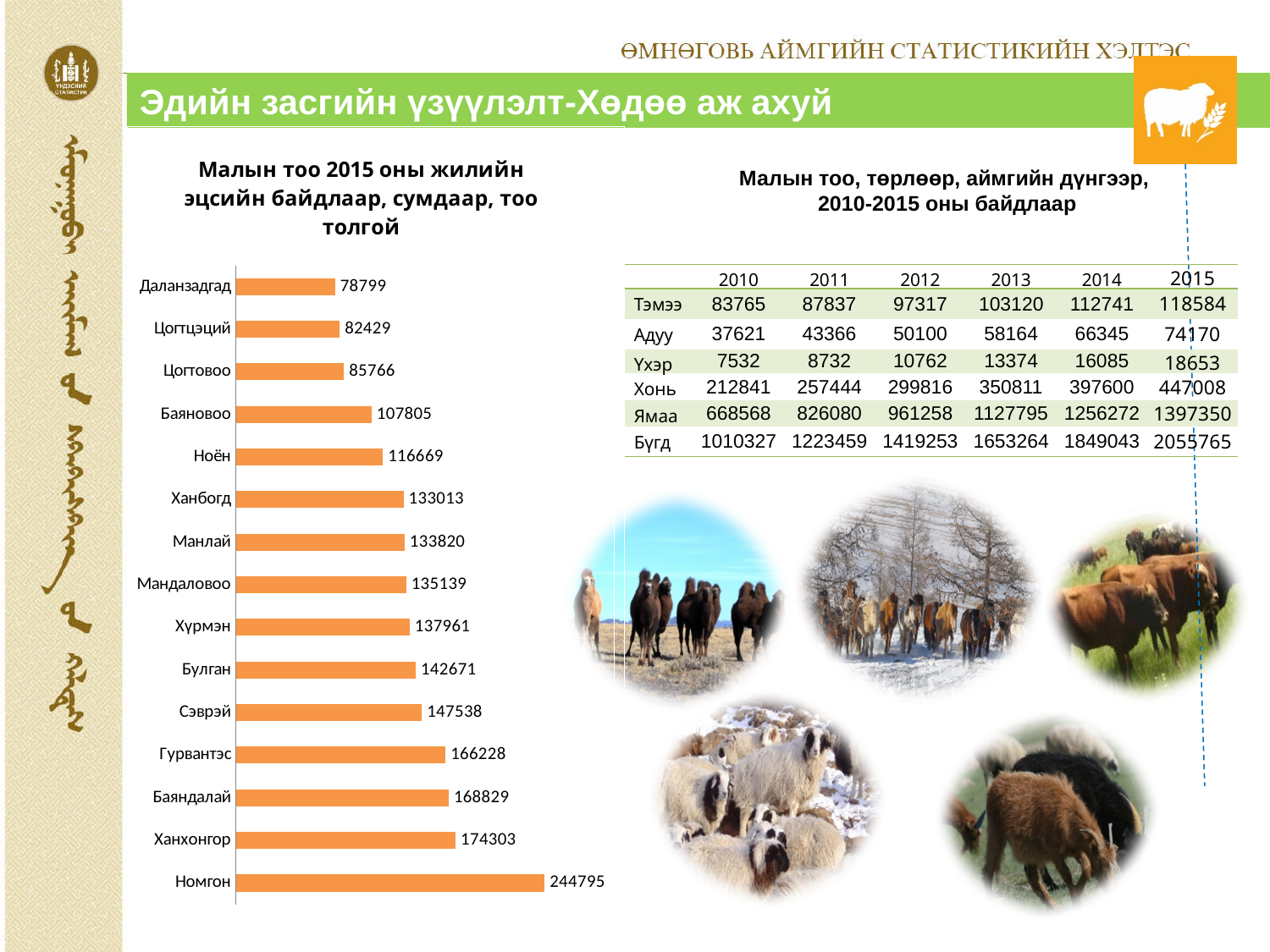
Which category has the lowest value in the bar chart? Даланзадгад What is the value for Ханбогд in the bar chart? 133013 What is the value for Номгон in the bar chart? 244795 What is the value for Даланзадгад in the bar chart? 78799 What is the title of the bar chart? Малын тоо 2015 оны жилийн эцсийн байдлаар, сумдаар, тоо толгой What is the difference between the values for Баяндалай and Гурвантэс in the bar chart? 2601 What is the value for Гурвантэс in the bar chart? 166228 What kind of chart is shown on the left of the slide? Bar chart Which category has the highest value in the bar chart? Номгон What is the difference between the values for Номгон and Ханхонгор in the bar chart? 70492 Which has a larger value in the bar chart, Сэврэй or Гурвантэс? Гурвантэс How many categories (sums) are shown in the bar chart? 15